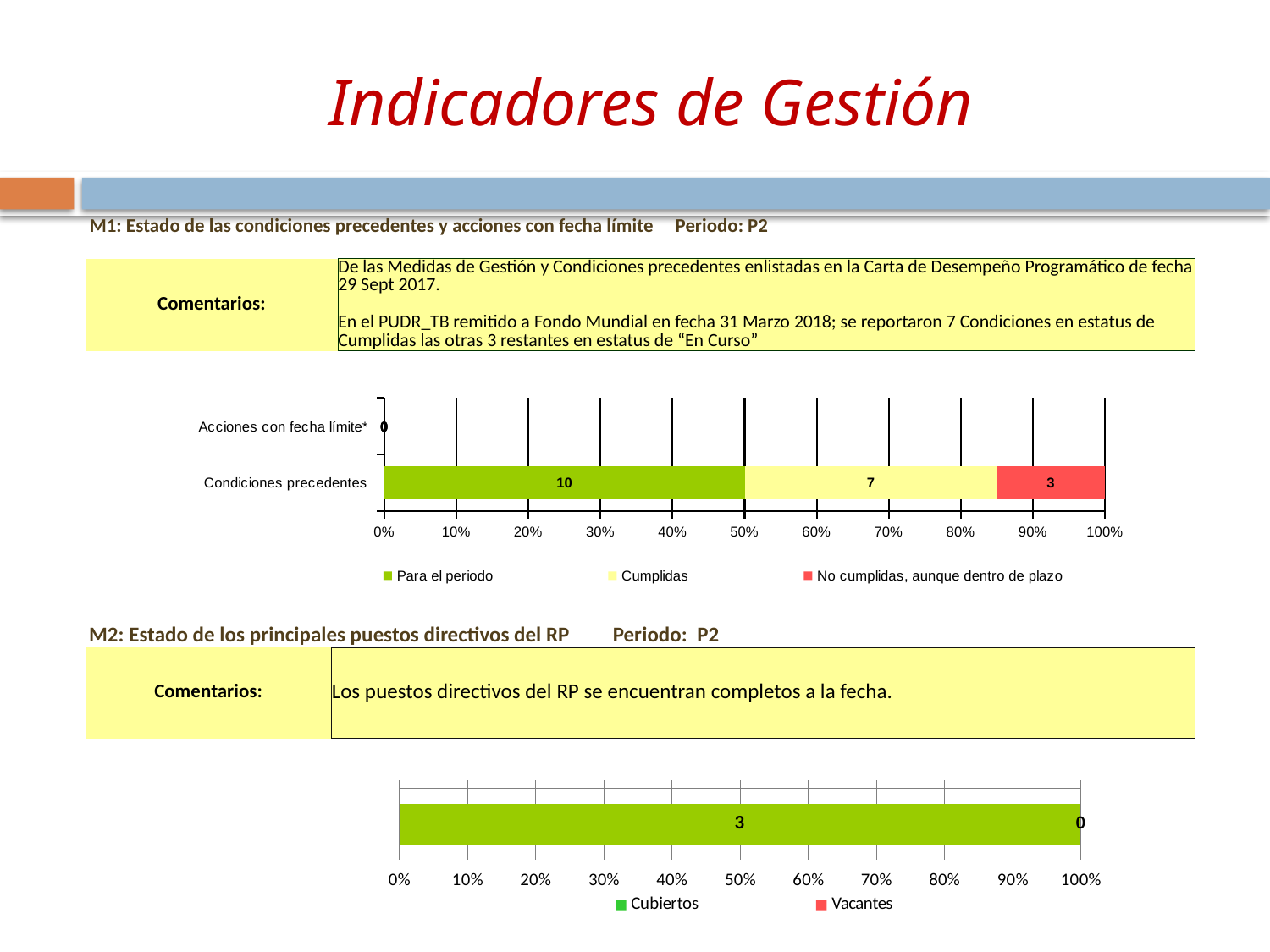
In the top chart (M1), what is the value of 'Para el periodo' for Condiciones precedentes? 10 In the top chart (M1), what is the difference between the 'Cumplidas' value and the 'No cumplidas, aunque dentro de plazo' value for Condiciones precedentes? 4 In the top chart (M1), how many categories are shown on the vertical axis? 2 In the top chart (M1), what is the value of 'Cumplidas' for Condiciones precedentes? 7 What kind of chart is the top chart (M1)? Stacked bar chart In the top chart (M1), what is the value of 'No cumplidas, aunque dentro de plazo' for Condiciones precedentes? 3 In the top chart (M1), which series has the largest value for Condiciones precedentes? Para el periodo In the top chart (M1), how many series does the legend list? 3 In the top chart (M1), what value is shown for Acciones con fecha límite*? 0 In the bottom chart (M2), how many series does the legend list? 2 In the bottom chart (M2), what is the value for Cubiertos? 3 In the bottom chart (M2), what is the value for Vacantes? 0